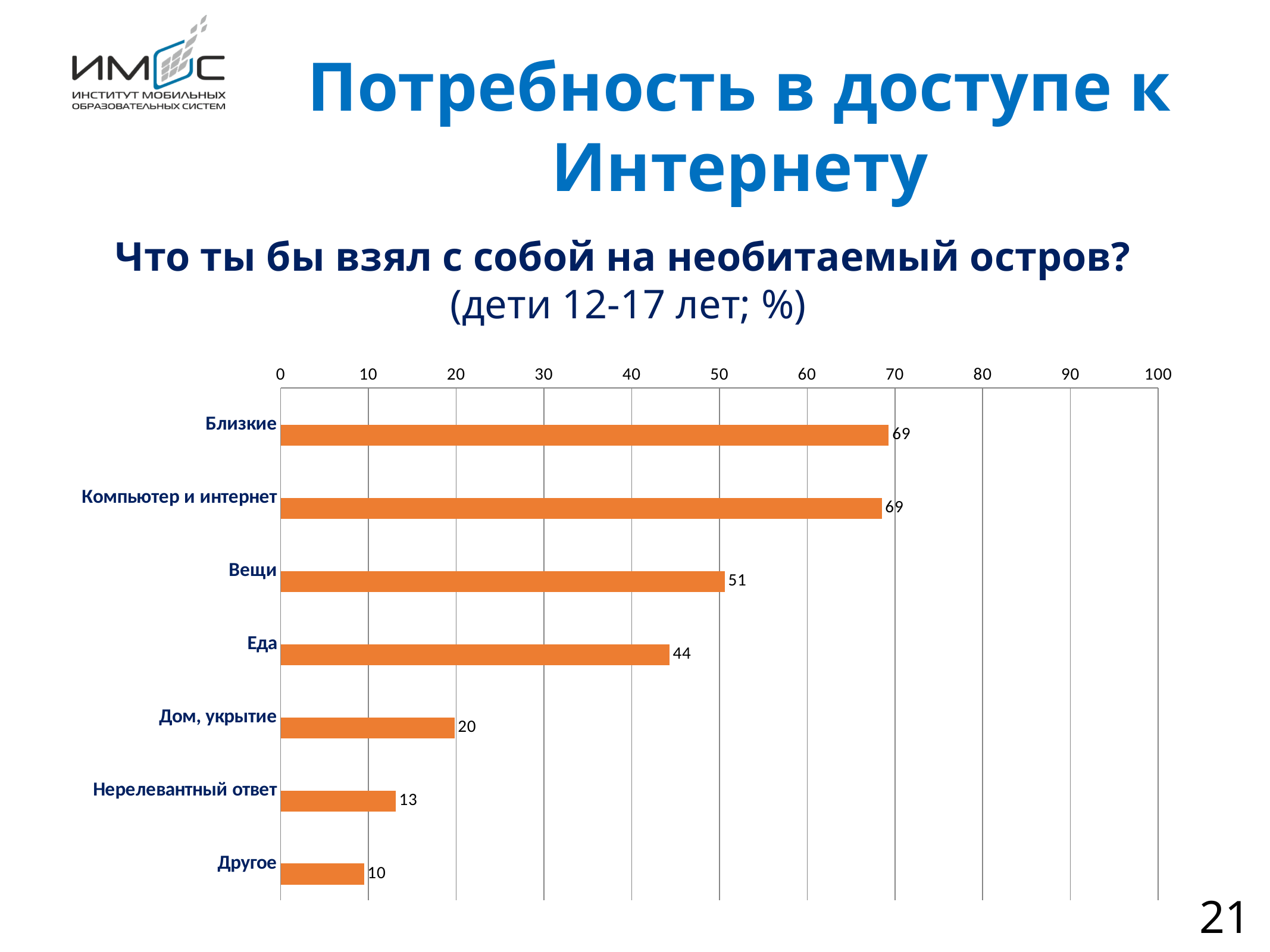
What is the difference between the values for Близкие and Дом, укрытие? 49 What is the difference between the values for Вещи and Еда? 7 What kind of chart is shown on the slide? bar chart Which category has the lowest value? Другое What value is shown for Дом, укрытие? 20 How many categories are shown in the chart? 7 What value is shown for Нерелевантный ответ? 13 What value is shown for Вещи? 51 Is the value for Вещи greater or less than 50? greater What value is shown for Еда? 44 Which is larger, the value for Еда or the value for Дом, укрытие? Еда What value is shown for Компьютер и интернет? 69